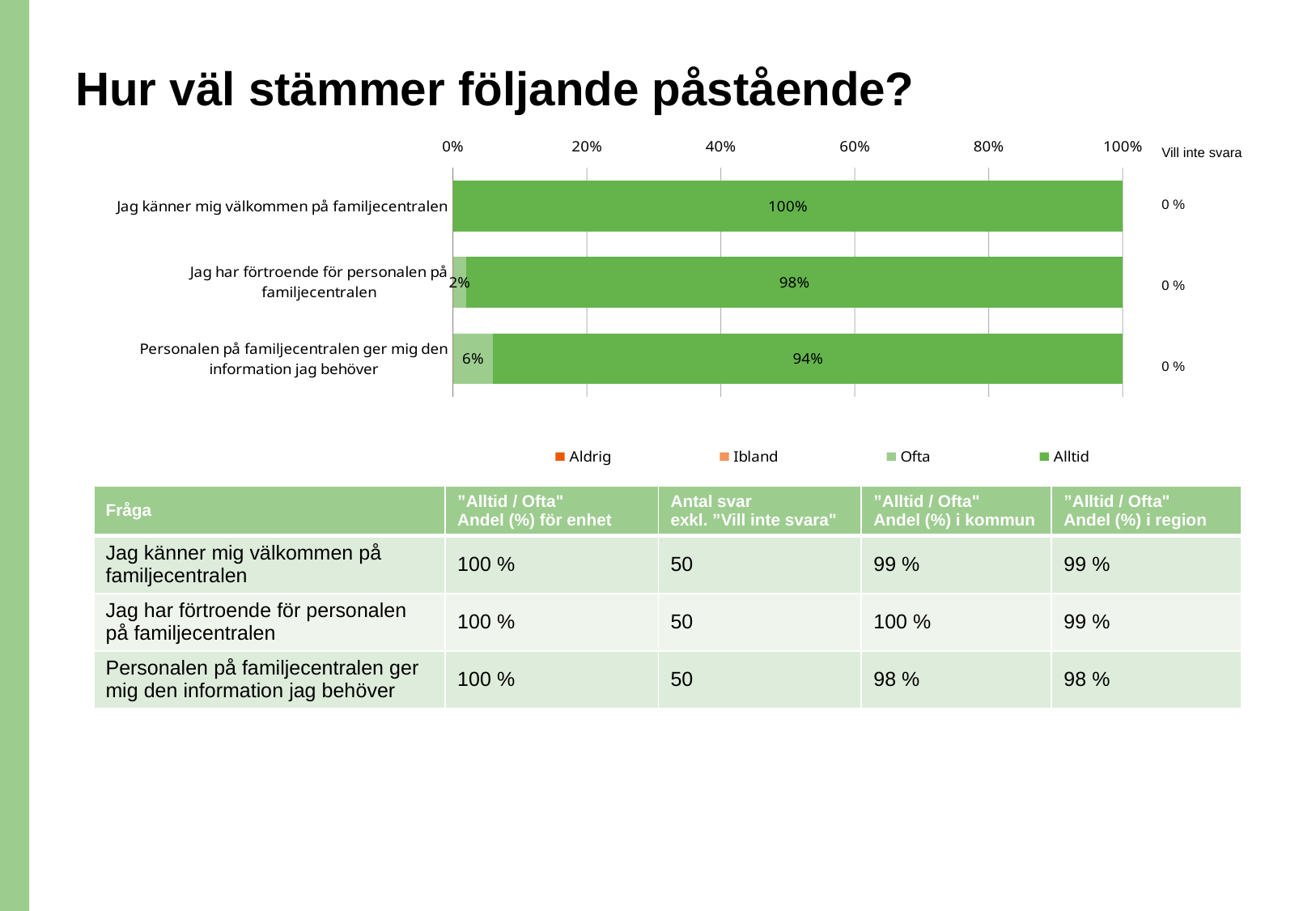
What is the title of the slide containing the chart? Hur väl stämmer följande påstående? How many series does the chart legend list? 4 Which is larger: the "Ofta" value for "Jag har förtroende för personalen på familjecentralen" or for "Personalen på familjecentralen ger mig den information jag behöver"? Personalen på familjecentralen ger mig den information jag behöver What type of chart is shown on the slide? Stacked bar chart What is the "Alltid" value for "Jag känner mig välkommen på familjecentralen"? 100% What is the difference between the "Alltid" values for "Jag har förtroende för personalen på familjecentralen" and "Personalen på familjecentralen ger mig den information jag behöver"? 4% Which statement has the lowest "Alltid" value? Personalen på familjecentralen ger mig den information jag behöver What is the "Alltid" value for "Personalen på familjecentralen ger mig den information jag behöver"? 94% What is the "Ofta" value for "Personalen på familjecentralen ger mig den information jag behöver"? 6% What is the "Alltid" value for "Jag har förtroende för personalen på familjecentralen"? 98% Which statement has the highest "Alltid" value? Jag känner mig välkommen på familjecentralen How many statements (categories) are plotted in the chart? 3